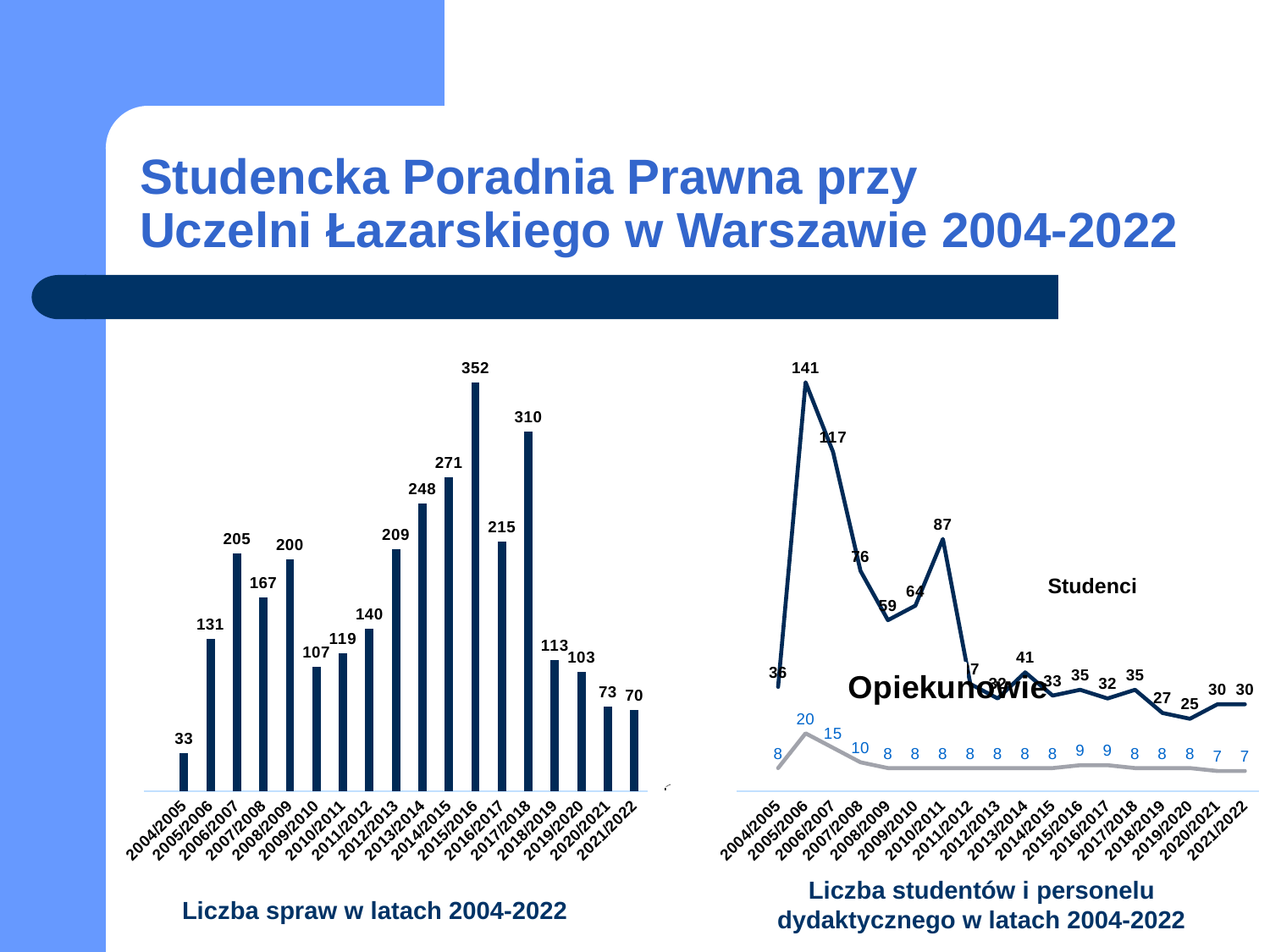
What type of chart is 'Liczba spraw w latach 2004-2022'? bar chart In the chart 'Liczba spraw w latach 2004-2022', which year has the lowest number of cases? 2004/2005 In the chart 'Liczba studentów i personelu dydaktycznego w latach 2004-2022', which year has the highest Opiekunowie value? 2005/2006 In the chart 'Liczba studentów i personelu dydaktycznego w latach 2004-2022', what is the Studenci value for 2005/2006? 141 In the chart 'Liczba spraw w latach 2004-2022', what is the difference between the values for 2017/2018 and 2016/2017? 95 In the chart 'Liczba spraw w latach 2004-2022', which year has the highest value? 2015/2016 How many bars are shown in the chart 'Liczba spraw w latach 2004-2022'? 18 In the chart 'Liczba studentów i personelu dydaktycznego w latach 2004-2022', what is the Opiekunowie value for 2021/2022? 7 In the chart 'Liczba spraw w latach 2004-2022', do the values rise or fall from 2017/2018 to 2021/2022? fall What type of chart is 'Liczba studentów i personelu dydaktycznego w latach 2004-2022'? line chart In the chart 'Liczba spraw w latach 2004-2022', what is the value for 2015/2016? 352 In the chart 'Liczba spraw w latach 2004-2022', which is larger, the value for 2006/2007 or the value for 2008/2009? 2006/2007